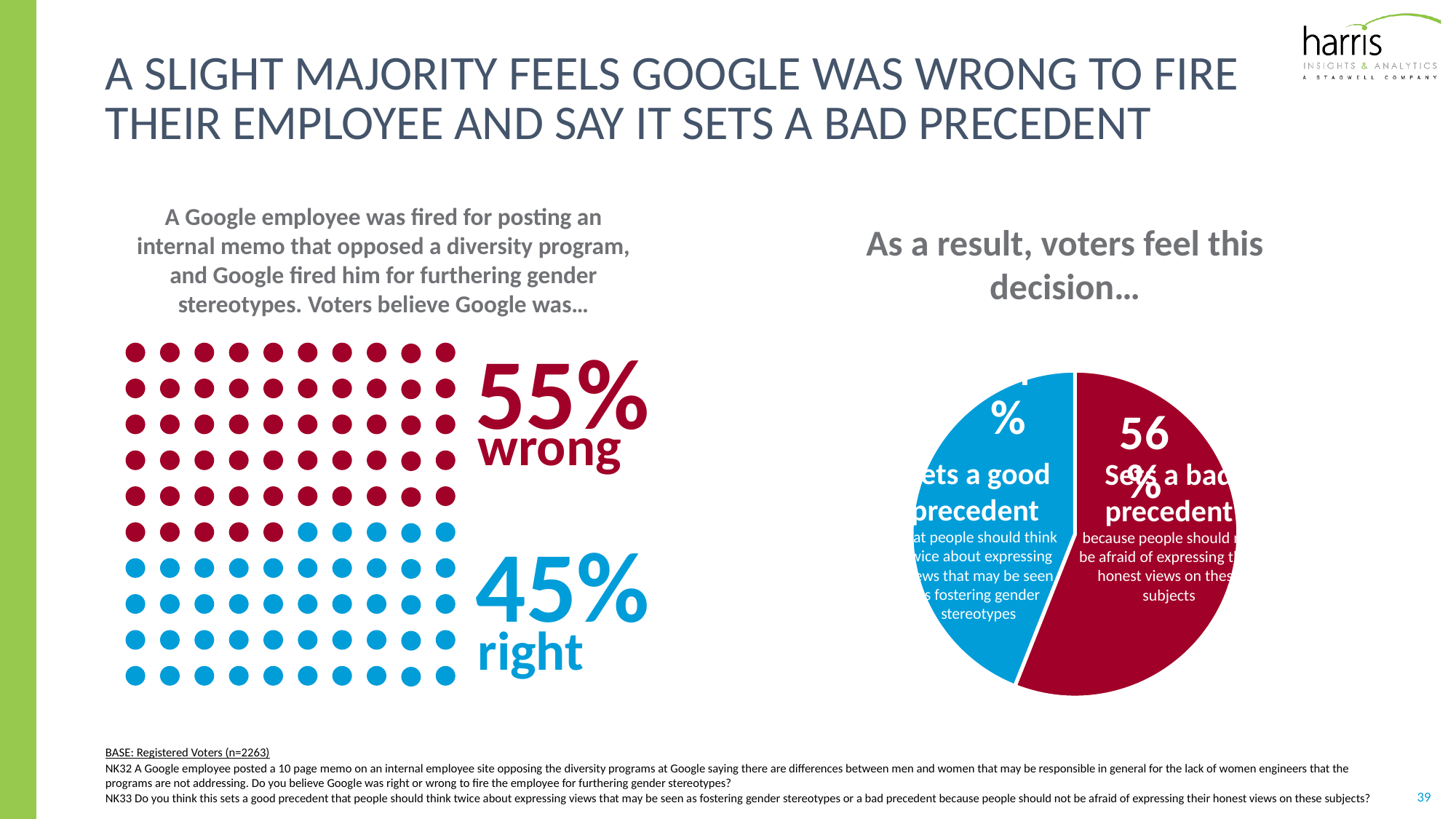
In the pie chart on the right, which is larger: 'Sets a good precedent' or 'Sets a bad precedent'? Sets a bad precedent In the left chart, which response is larger: wrong or right? wrong In the pie chart on the right, which slice is the largest? Sets a bad precedent What kind of chart is shown on the right side of the slide? Pie chart In the left chart, what percentage of voters believe Google was right to fire the employee? 45% How many slices does the pie chart on the right have? 2 How many response categories does the left chart show? 2 In the left chart, what is the difference in percentage points between those who say Google was wrong and those who say it was right? 10 percentage points In the left chart, what colour are the dots representing 'right'? Blue In the pie chart on the right, what share of voters say the decision sets a bad precedent? 56% In the left chart, what percentage of voters believe Google was wrong to fire the employee? 55% In the pie chart on the right, what colour is the 'Sets a bad precedent' slice? Red